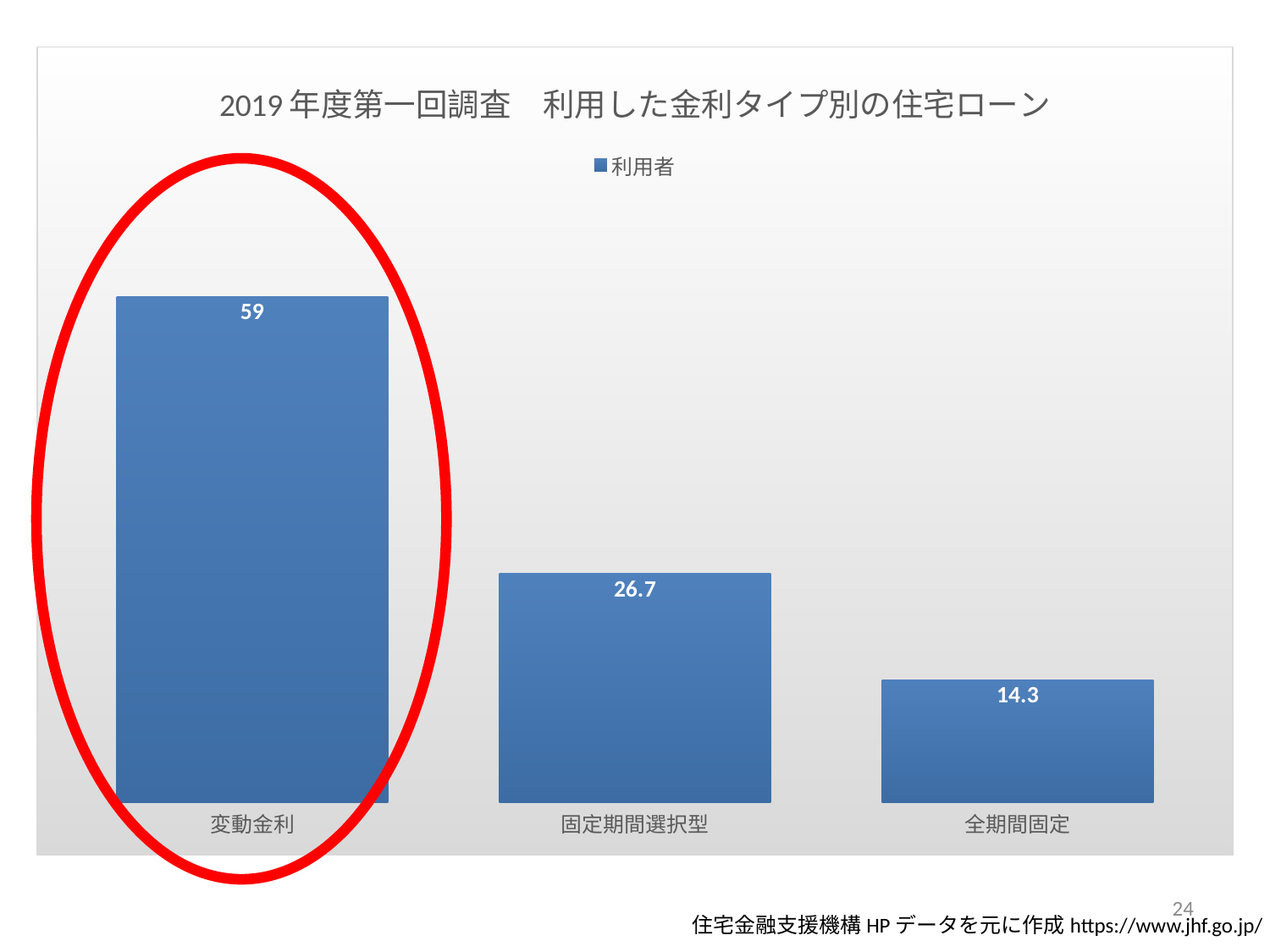
What is the value for 変動金利? 59 What is the value for 固定期間選択型? 26.7 Which category has the highest value? 変動金利 Which is larger, the value for 固定期間選択型 or 全期間固定? 固定期間選択型 How many series does the legend list? 1 How many categories are shown on the x axis? 3 Which category is circled in red on the slide? 変動金利 What is the difference between the values for 変動金利 and 固定期間選択型? 32.3 What kind of chart is this? bar chart Which category has the lowest value? 全期間固定 What is the value for 全期間固定? 14.3 What is the difference between the values for 固定期間選択型 and 全期間固定? 12.4